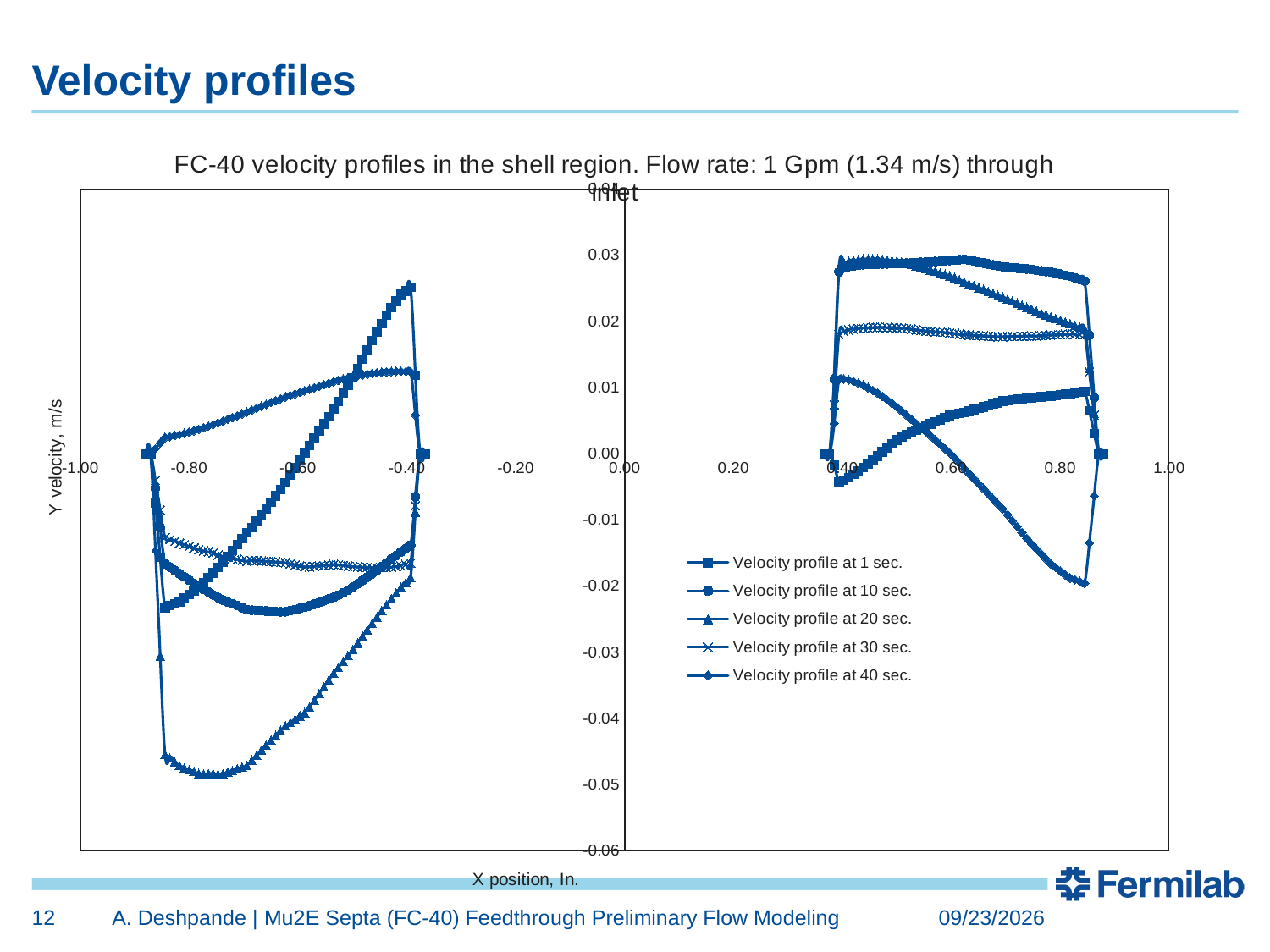
Is the lowest value of the 'Velocity profile at 20 sec.' series greater or less than -0.04? less Is the lowest value of the 'Velocity profile at 10 sec.' series on the negative-x side greater or less than -0.02? less How many series does the legend list? 5 What is the title of the chart? FC-40 velocity profiles in the shell region. Flow rate: 1 Gpm (1.34 m/s) through inlet What kind of chart is shown on the slide? line chart What is the label of the vertical axis? Y velocity, m/s On the positive-x side, which series reaches a higher Y velocity: 'Velocity profile at 10 sec.' or 'Velocity profile at 1 sec.'? Velocity profile at 10 sec. Is the lowest value of the 'Velocity profile at 40 sec.' series on the positive-x side greater or less than -0.01? less On the negative-x side, which series reaches a lower Y velocity: 'Velocity profile at 20 sec.' or 'Velocity profile at 30 sec.'? Velocity profile at 20 sec. Which series reaches the lowest Y velocity on the chart? Velocity profile at 20 sec.